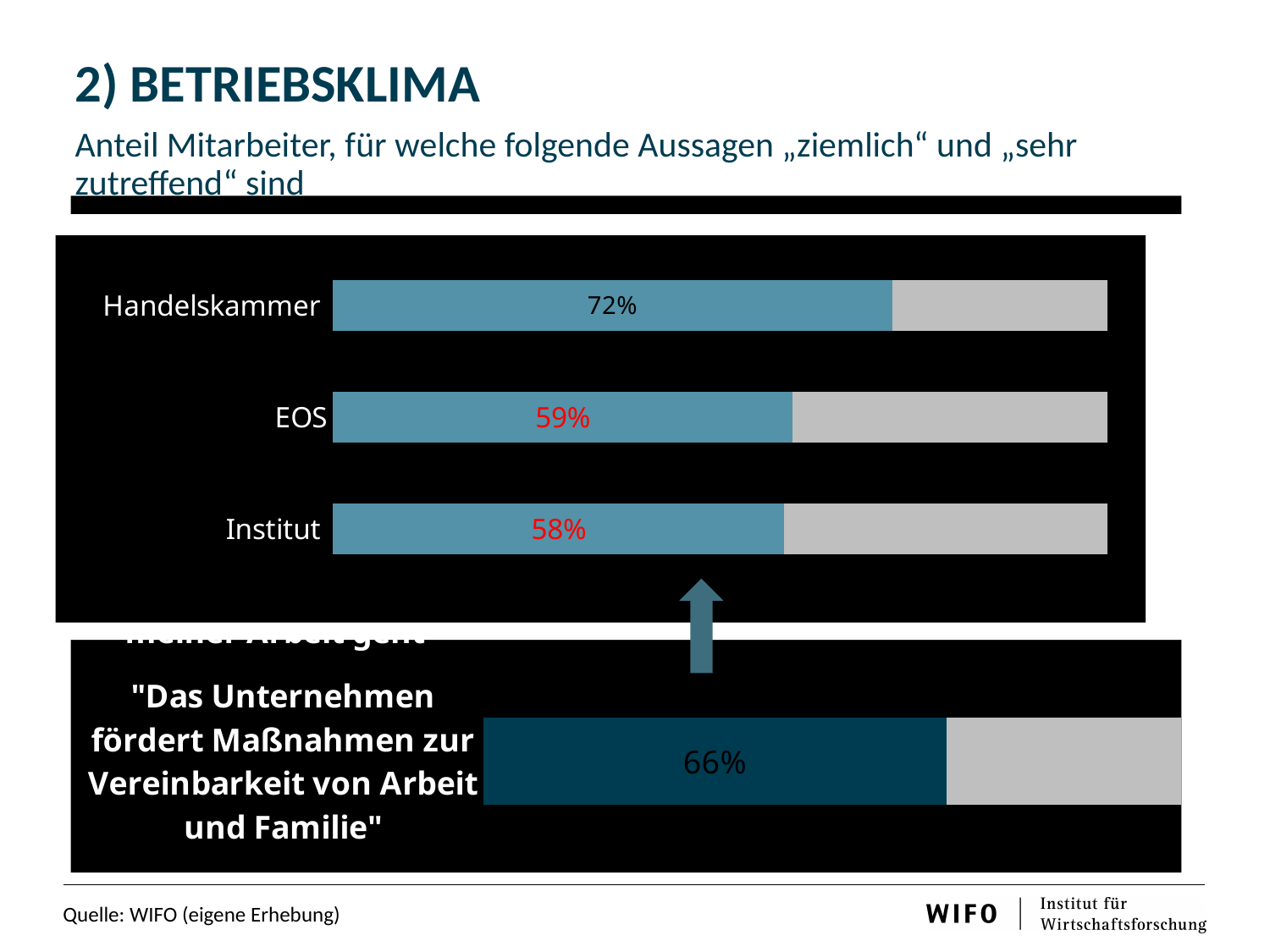
In the upper chart, which category has the highest value? Handelskammer In the upper chart, what is the difference between the values for Handelskammer and EOS? 13 percentage points In the lower chart, what is the value for the statement "Das Unternehmen fördert Maßnahmen zur Vereinbarkeit von Arbeit und Familie"? 66% In the upper chart, what is the difference between the values for Handelskammer and Institut? 14 percentage points In the upper chart, which categories have their value labels printed in red? EOS and Institut What kind of chart is the upper chart? Bar chart In the upper chart, which category has the lowest value? Institut How many categories are shown in the upper chart? 3 In the upper chart, what is the value for Institut? 58% In the upper chart, which is larger: the value for Handelskammer or the value for EOS? Handelskammer In the upper chart, what is the value for EOS? 59% In the upper chart, what is the value for Handelskammer? 72%